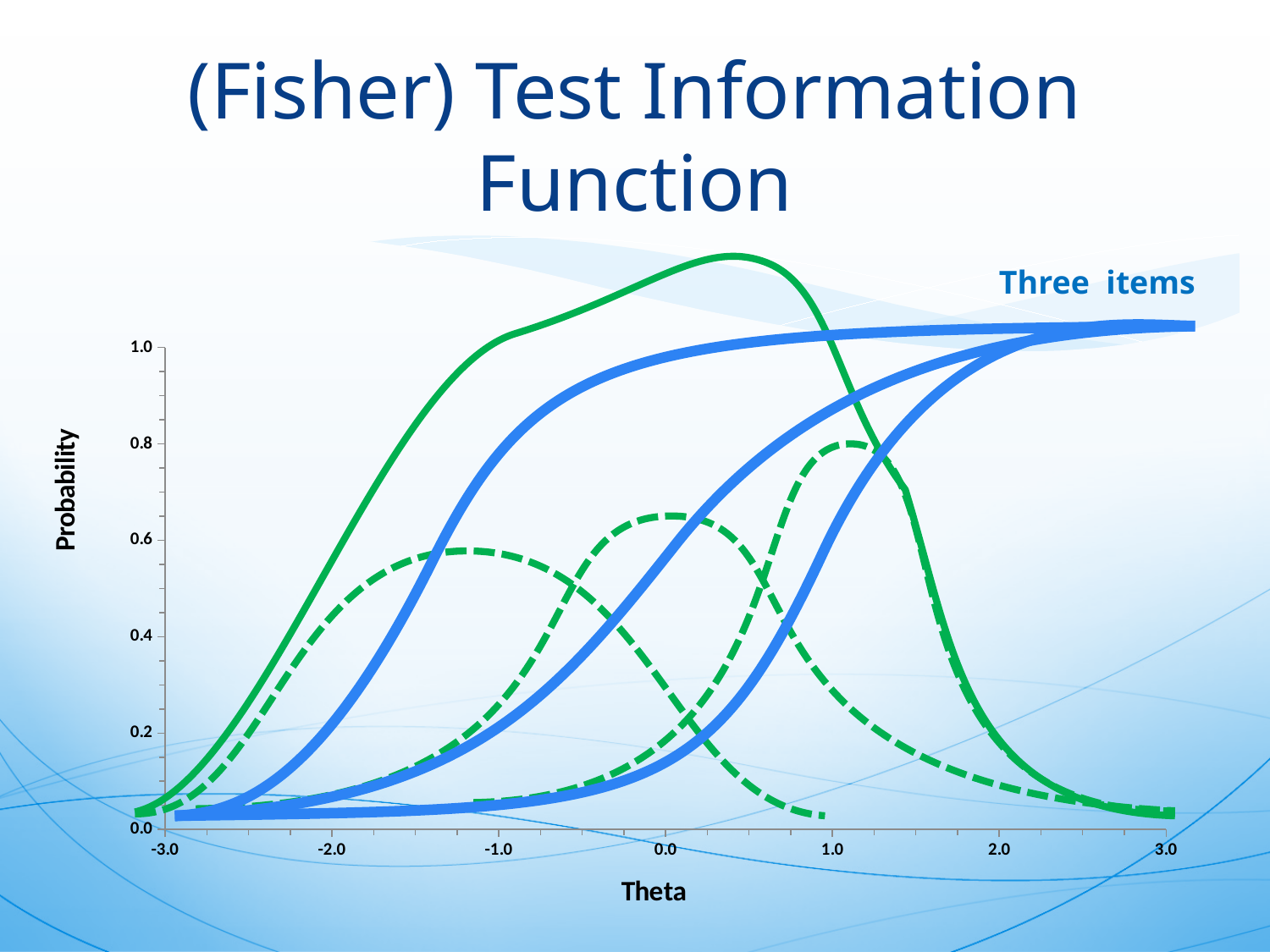
What is the label of the x axis? Theta Is the value of the solid green curve at Theta 0.0 greater or less than 0.8? greater How many labelled tick marks are there on the Theta axis? 7 Do the solid blue curves rise or fall as Theta increases? rise What is the title of the chart on the slide? (Fisher) Test Information Function At Theta 0.0, which is higher: the leftmost solid blue curve or the rightmost solid blue curve? the leftmost solid blue curve How many solid blue curves are plotted on the chart? 3 What kind of chart is shown on the slide? line chart Is the value of the rightmost solid blue curve at Theta 0.0 greater or less than 0.4? less How many dashed green curves are plotted on the chart? 3 Is the peak of the rightmost dashed green curve greater or less than 0.6? greater